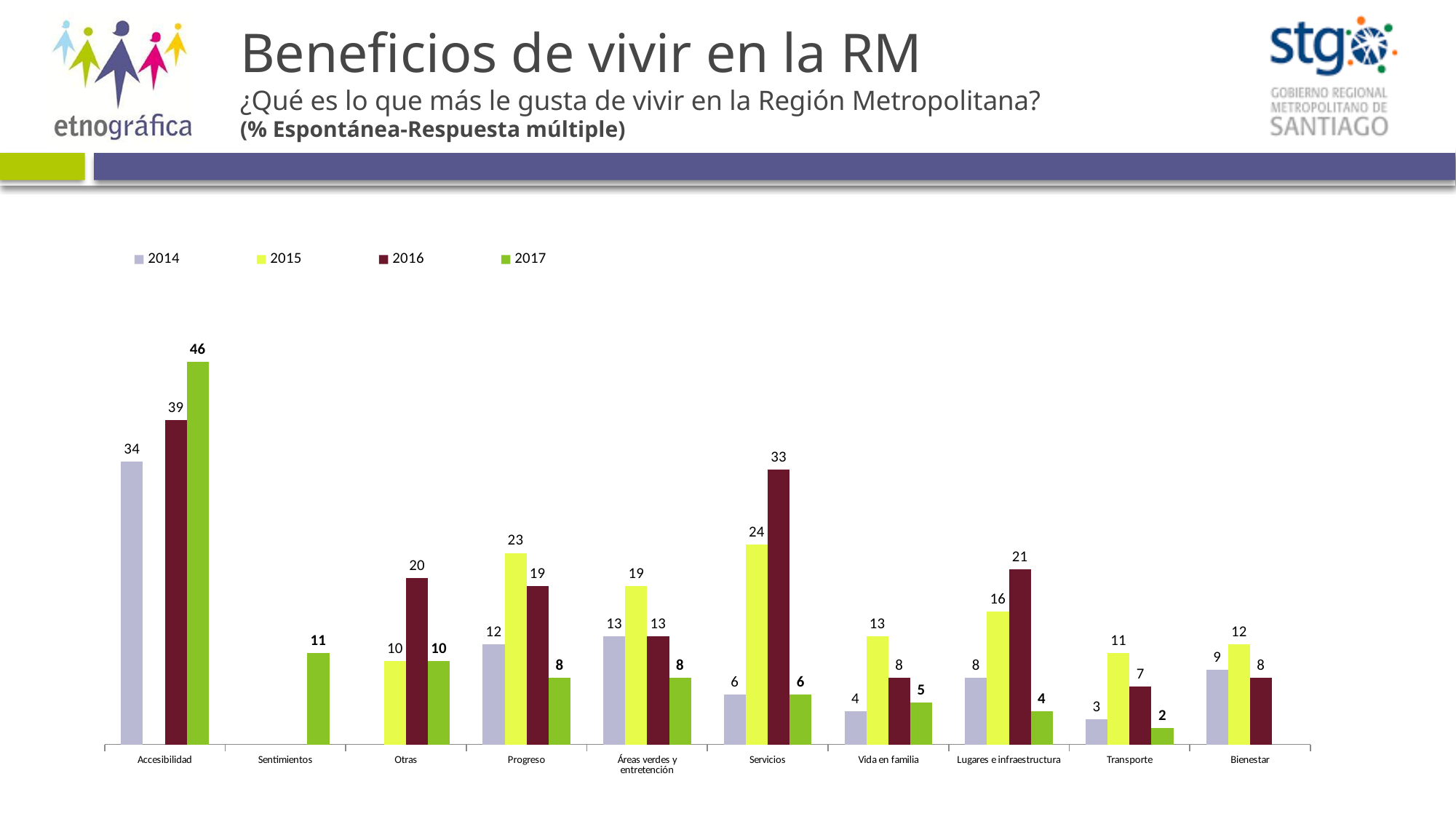
How many series does the legend list? 4 What kind of chart is shown on the slide? Bar chart Which category has the lowest value in 2017? Transporte How many categories are shown on the x axis? 10 What is the value for Transporte in 2015? 11 What is the difference between the 2016 and 2015 values for Servicios? 9 Which category has the highest value in 2017? Accesibilidad What is the value for Servicios in 2016? 33 Which is larger for Progreso: the 2015 value or the 2016 value? 2015 Which years are listed in the legend? 2014, 2015, 2016, 2017 What is the value for Accesibilidad in 2017? 46 What is the difference between the 2016 and 2014 values for Accesibilidad? 5